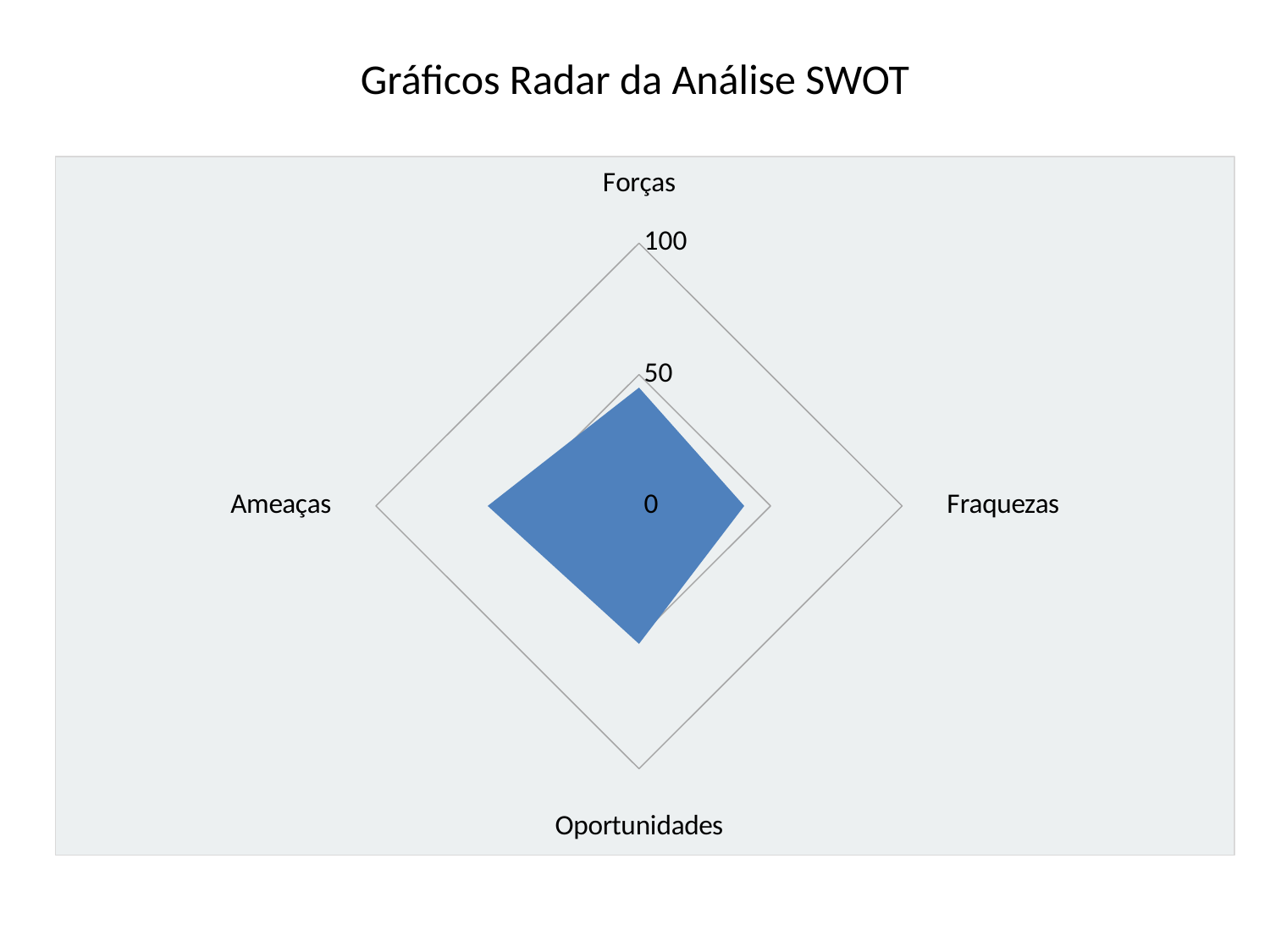
Is the value for Forças greater or less than 100? less How many categories (axes) does the radar chart have? 4 What kind of chart is shown on the slide? Radar chart Is the value for Fraquezas greater or less than 50? less Which category has the highest value on the radar chart? Ameaças What is the title of the slide? Gráficos Radar da Análise SWOT Is the value for Oportunidades greater or less than 100? less What is the maximum value shown on the radar chart's axis scale? 100 Which is larger, the value for Forças or the value for Ameaças? Ameaças Which is larger, the value for Ameaças or the value for Fraquezas? Ameaças Which category has the lowest value on the radar chart? Fraquezas